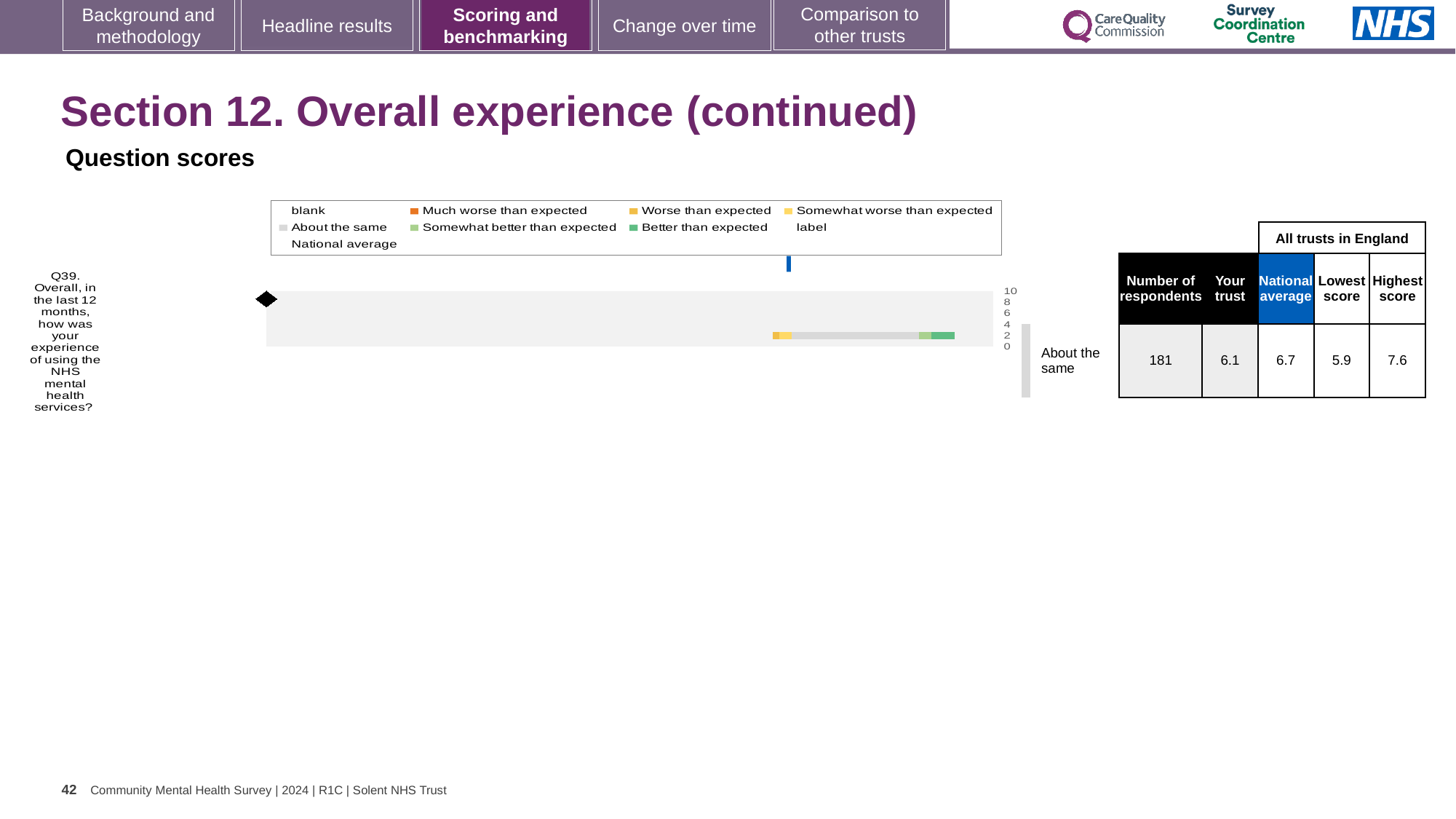
What benchmark label is shown next to the chart for Q39? About the same How many questions (categories) are plotted in the chart? 1 What is the lowest score among all trusts in England for Q39? 5.9 Which is larger for Q39, the 'Your trust' score or the national average? National average What is the highest score among all trusts in England for Q39? 7.6 Which question is plotted in the chart? Q39. Overall, in the last 12 months, how was your experience of using the NHS mental health services? What is the national average score for Q39? 6.7 What is the difference between the highest score and the lowest score for Q39? 1.7 What is the difference between the national average and the 'Your trust' score for Q39? 0.6 What is the 'Your trust' score for Q39? 6.1 What kind of chart is shown on the slide? bar chart How many respondents answered Q39? 181